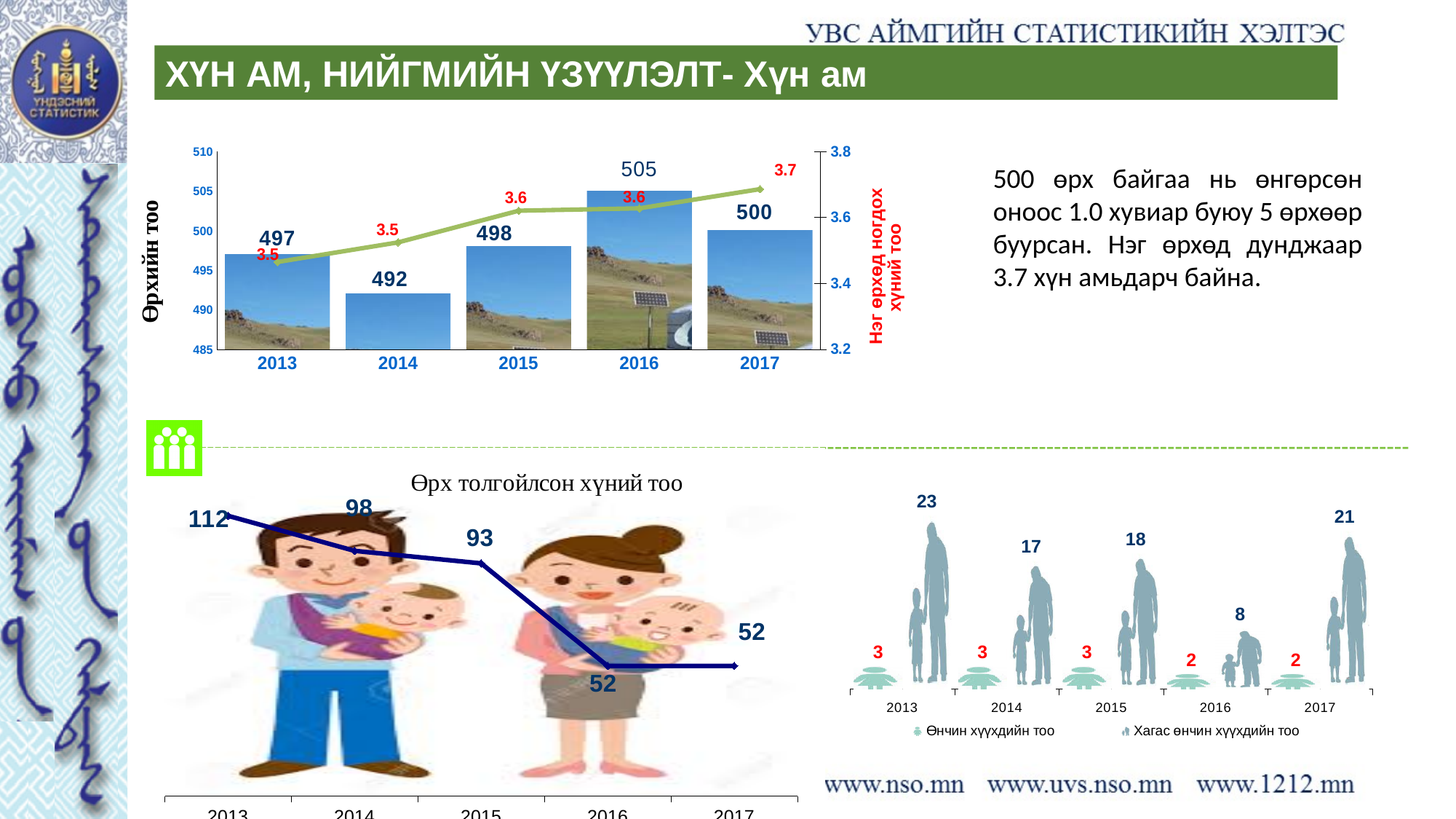
In the top-left chart, what is the difference between the number of households in 2016 and 2017? 5 In the chart titled 'Өрх толгойлсон хүний тоо', how many years are plotted? 5 In the top-left chart, what is the number of households (Өрхийн тоо) in 2016? 505 In the top-left chart, which year has the lowest number of households? 2014 In the top-left chart, what is the average number of people per household (line series) in 2017? 3.7 In the top-left chart, which year has the highest number of households? 2016 In the bottom-right chart, which year has the lowest value of 'Хагас өнчин хүүхдийн тоо'? 2016 In the chart titled 'Өрх толгойлсон хүний тоо', what is the difference between the 2013 and 2014 values? 14 In the chart titled 'Өрх толгойлсон хүний тоо', what is the value for 2013? 112 In the bottom-right chart, what is the value of 'Хагас өнчин хүүхдийн тоо' in 2013? 23 In the top-left chart, does the people-per-household line rise or fall from 2013 to 2017? rise In the top-left chart, what is the number of households in 2014? 492